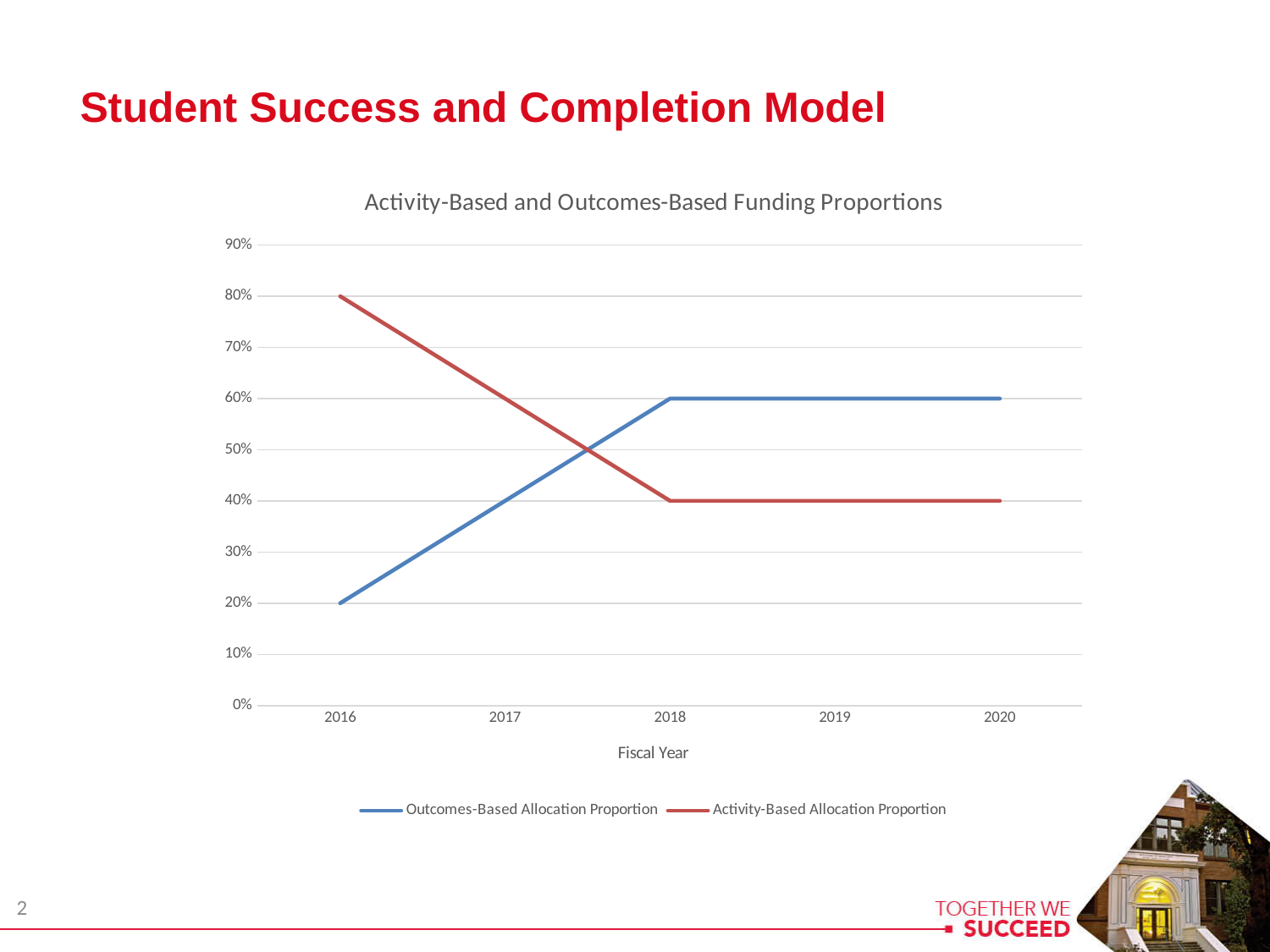
In which year is the Activity-Based Allocation Proportion highest? 2016 What is the title of the chart? Activity-Based and Outcomes-Based Funding Proportions How many fiscal years are shown on the x axis? 5 What is the difference between the Activity-Based and Outcomes-Based Allocation Proportions in 2016? 60% What is the Outcomes-Based Allocation Proportion in 2016? 20% What is the Outcomes-Based Allocation Proportion in 2020? 60% What is the Activity-Based Allocation Proportion in 2016? 80% What kind of chart is shown on the slide? line chart Which series has the higher value in 2016? Activity-Based Allocation Proportion Does the Outcomes-Based Allocation Proportion rise or fall from 2016 to 2018? rise What is the Activity-Based Allocation Proportion in 2018? 40% How many series does the legend list? 2